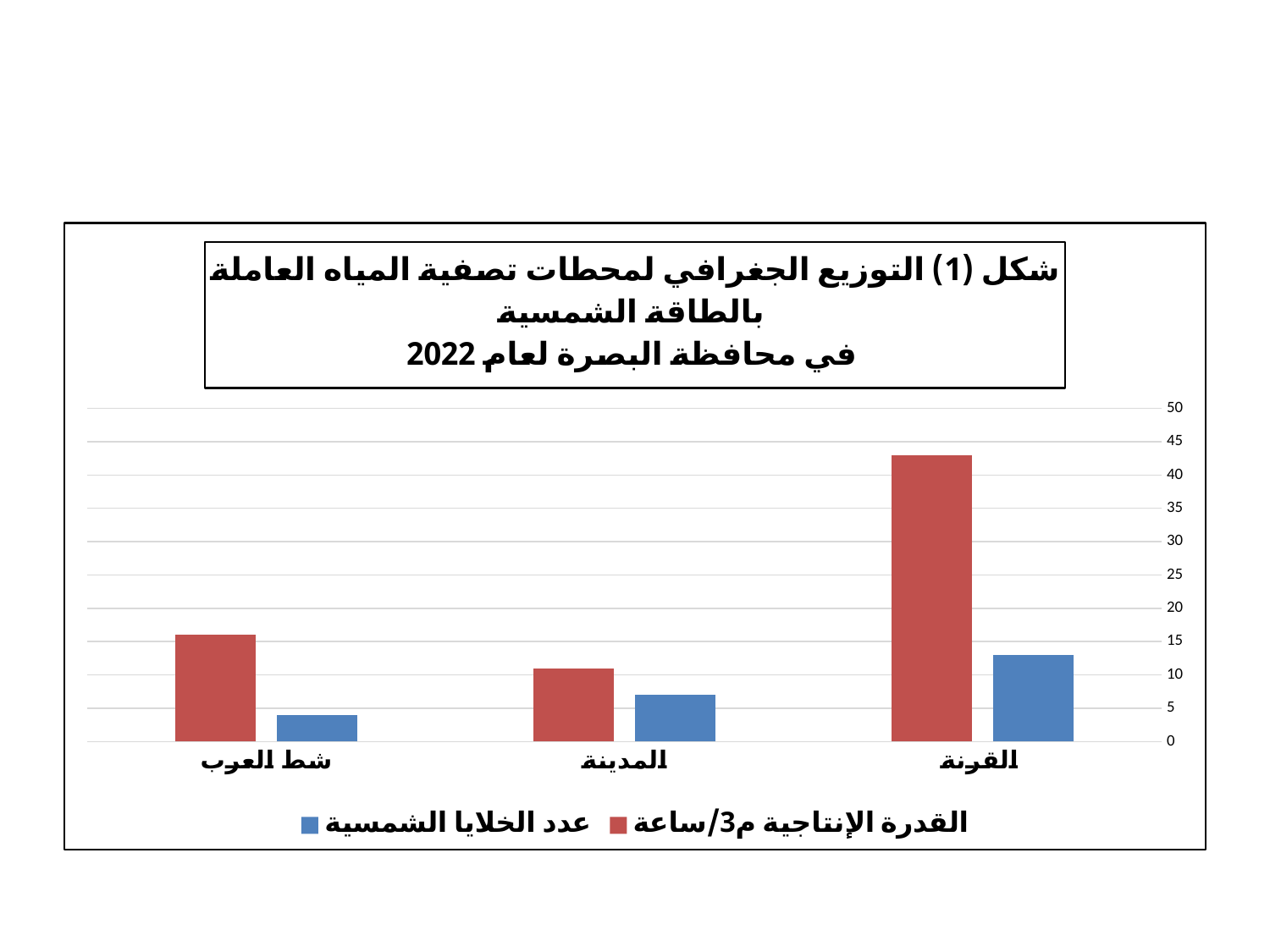
Which district has the lowest value for عدد الخلايا الشمسية? شط العرب Is the value of عدد الخلايا الشمسية for القرنة greater or less than 10? greater Which colour represents عدد الخلايا الشمسية in the chart? blue How many series does the legend list? 2 Which year does the chart title say the data is for? 2022 Which district has the highest value for القدرة الإنتاجية م3/ساعة? القرنة Which district has the lowest value for القدرة الإنتاجية م3/ساعة? المدينة Is the value of عدد الخلايا الشمسية for المدينة greater or less than 10? less Is the value of القدرة الإنتاجية م3/ساعة for القرنة greater or less than 40? greater What kind of chart is shown on the slide? bar chart How many categories (districts) are shown on the x axis? 3 Which is larger: القدرة الإنتاجية م3/ساعة for القرنة or for المدينة? القرنة